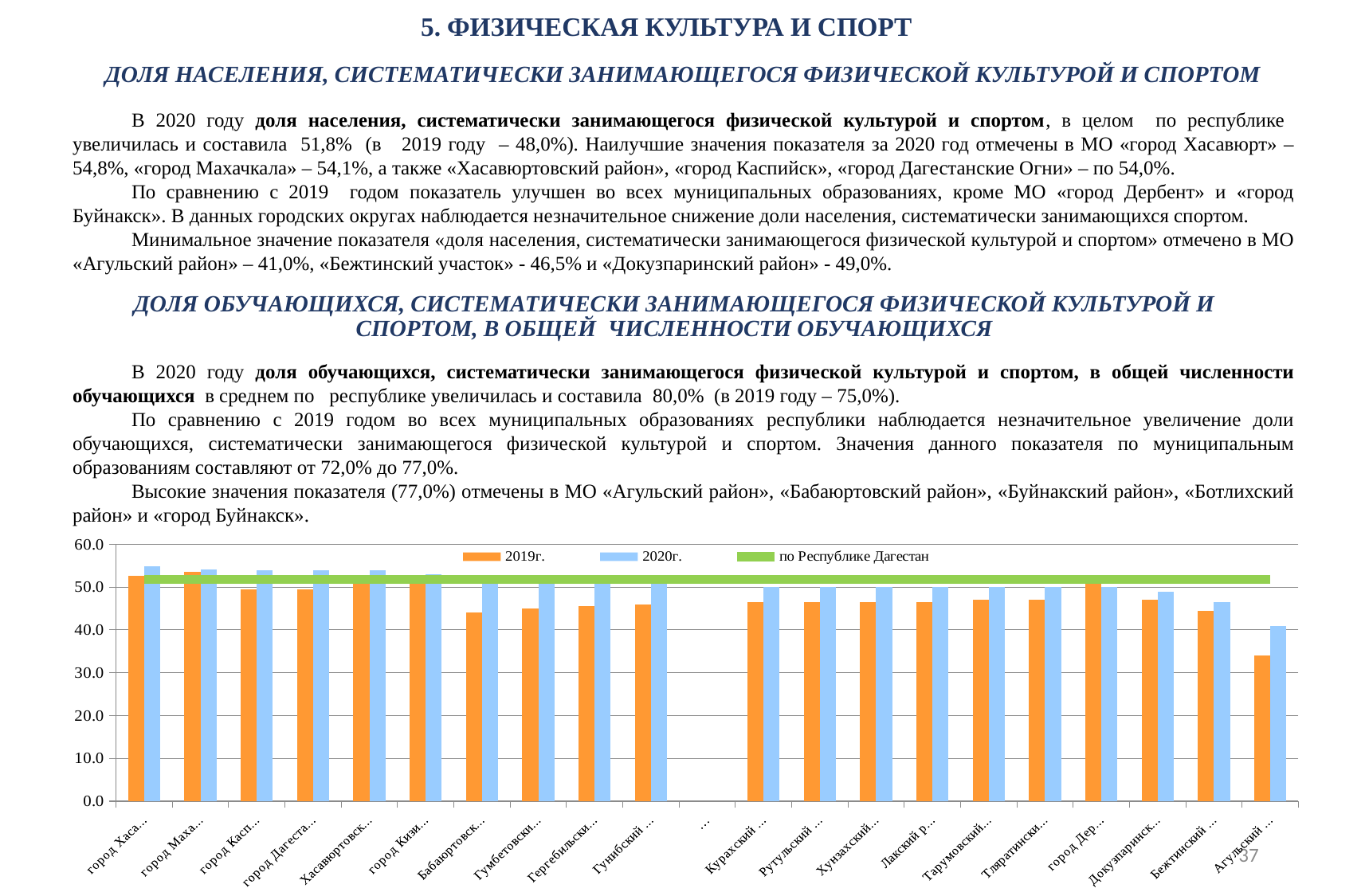
For Агульский, which is larger: the 2019г. bar or the 2020г. bar? 2020г. Is the 2019г. value for Агульский greater or less than 40.0? less What kind of chart is shown on the slide? combination bar and line chart Is the 2019г. value for Тарумовский greater or less than 50.0? less Which category has the lowest 2020г. bar in the chart? Агульский Is the 2020г. value for Бежтинский greater or less than 50.0? less Do the 2020г. bars generally rise or fall from left to right across the chart? fall How many series does the chart legend list? 3 Which colour represents the 2019г. series in the chart? orange Which category has the lowest 2019г. bar in the chart? Агульский What are the three entries in the chart legend? 2019г., 2020г., по Республике Дагестан